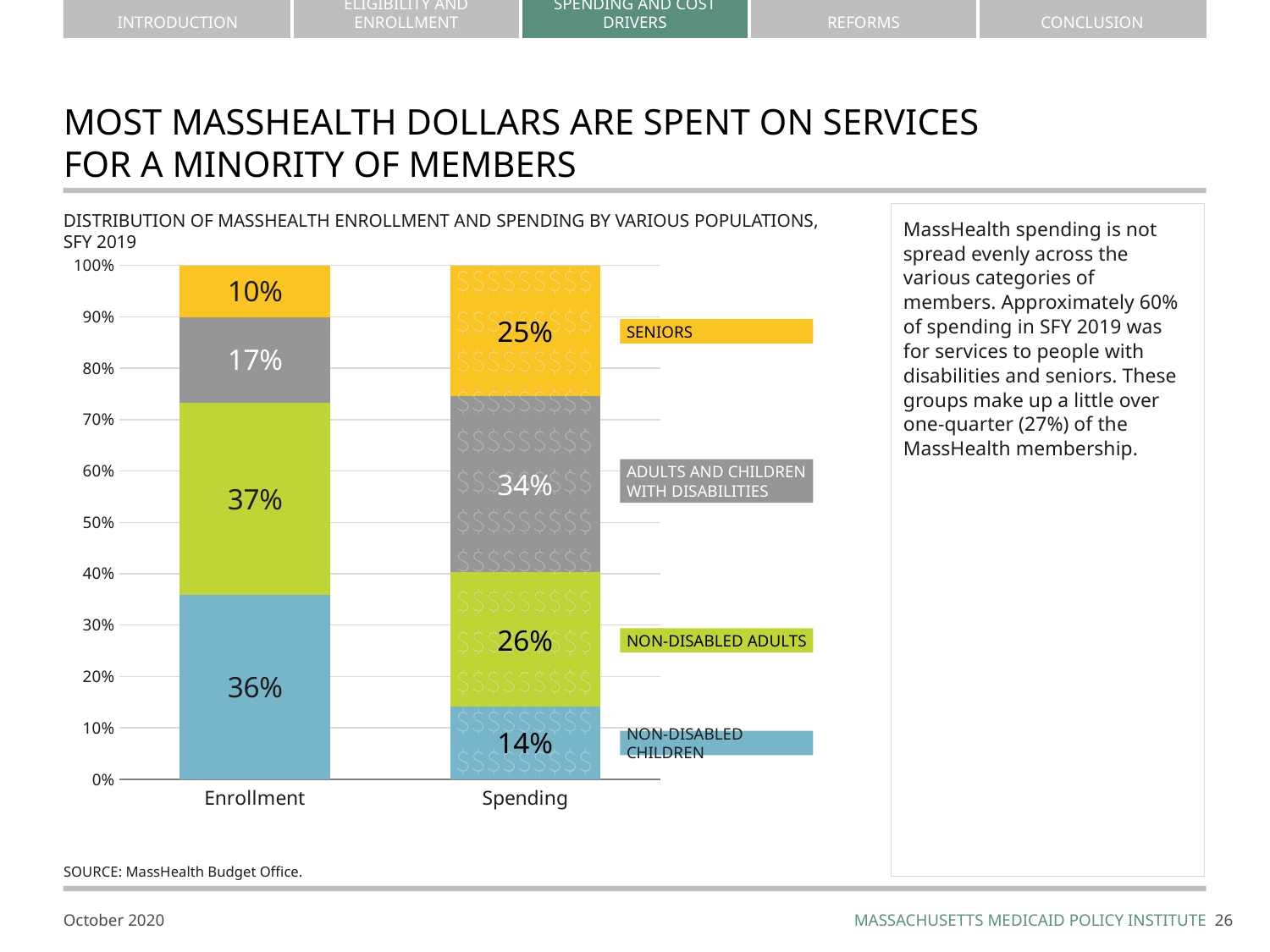
How many bars are shown on the chart? 2 What share of Enrollment is Non-Disabled Children? 36% What share of Enrollment is made up of Seniors? 10% What share of Spending goes to Adults and Children with Disabilities? 34% Which is larger: the Non-Disabled Children share of Enrollment or of Spending? Enrollment Which population has the smallest share of Enrollment? Seniors What is the combined share of Spending for Seniors and Adults and Children with Disabilities? 59% Which population has the largest share of Spending? Adults and Children with Disabilities How many population categories does the legend list? 4 What share of Spending goes to Non-Disabled Adults? 26% What is the difference between the Seniors share of Spending and the Seniors share of Enrollment? 15% What kind of chart is shown? Stacked bar chart